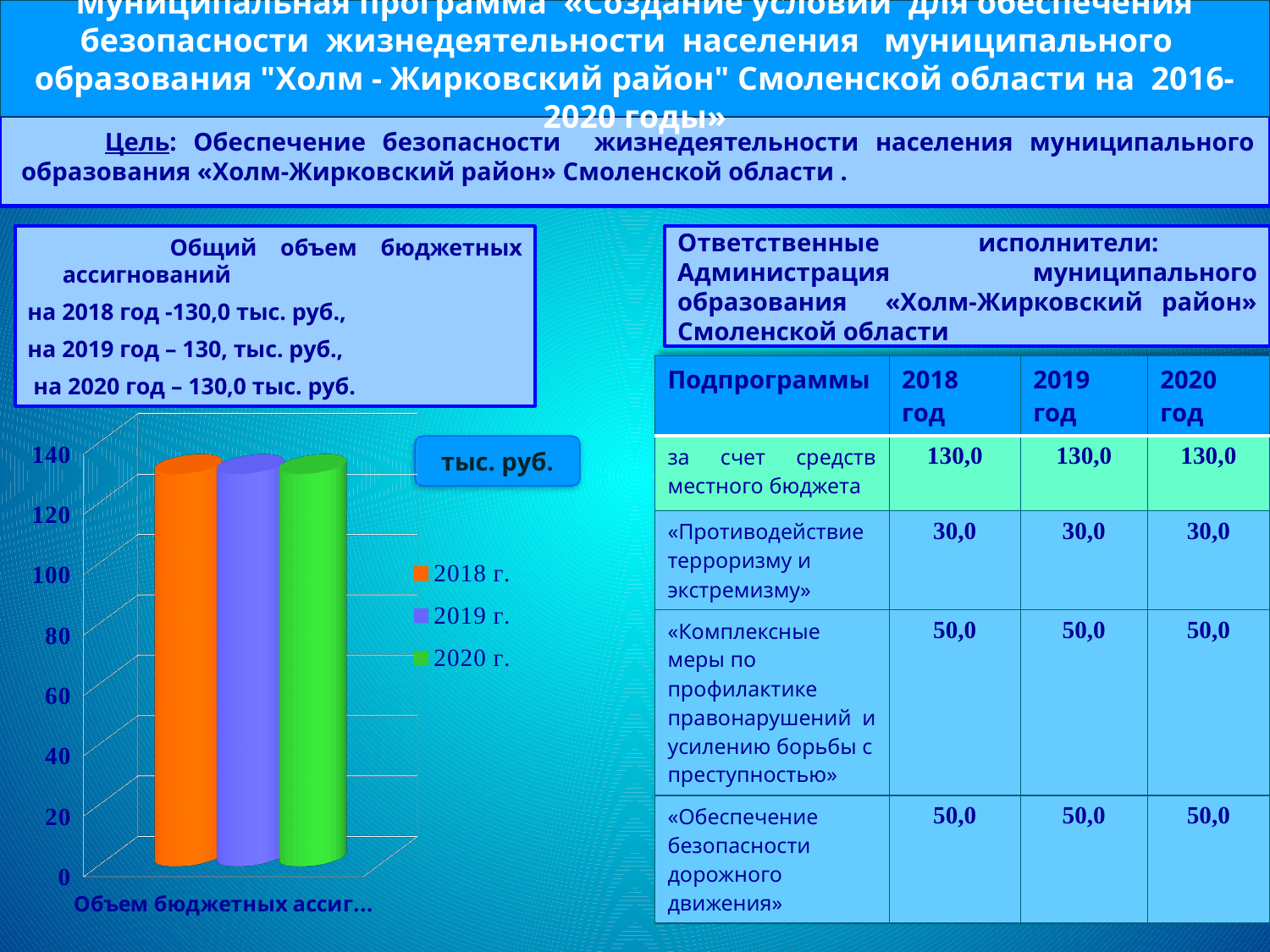
How many series does the chart legend list? 3 Is the value of the 2019 г. bar greater or less than 140? less Is the value of the 2018 г. bar greater or less than 120? greater How many categories are shown on the x axis of the chart? 1 Is the value of the 2018 г. bar greater or less than 140? less What unit label is shown in the box next to the chart? тыс. руб. What is the highest tick value shown on the vertical axis of the chart? 140 Which series in the chart legend is shown in orange? 2018 г. What kind of chart is shown on the slide? bar chart